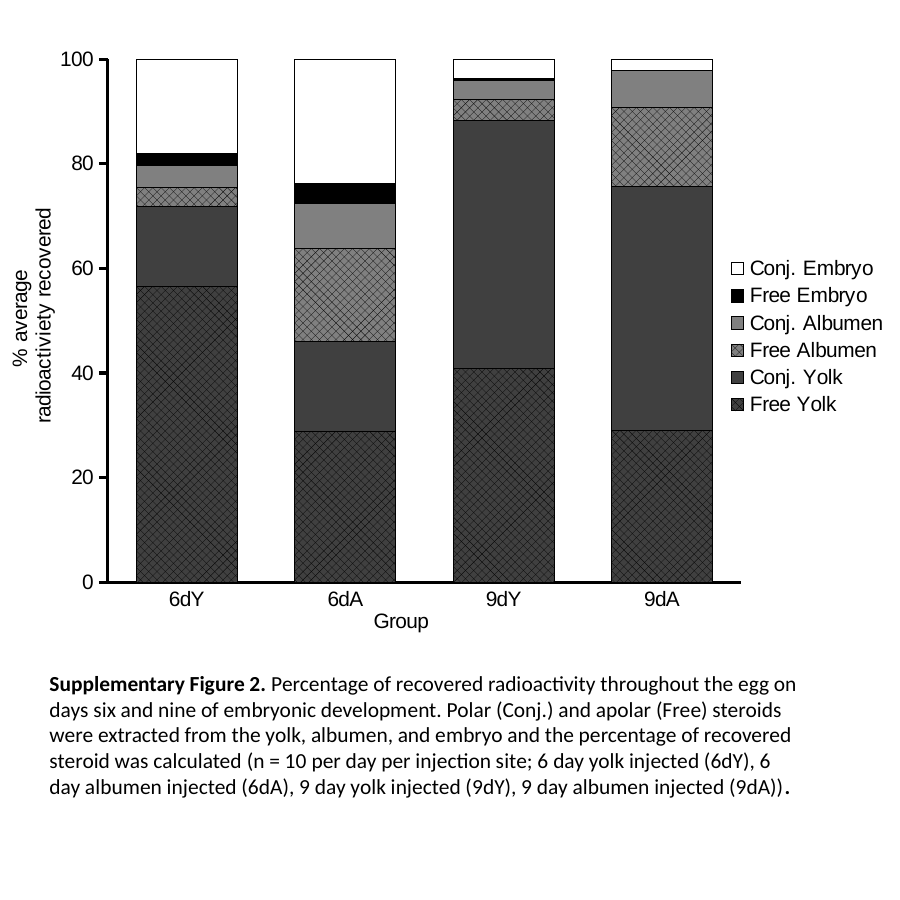
What kind of chart is shown on the slide? Stacked bar chart Is the Free Yolk value for 9dY greater or less than 20? greater What is the total height of the stacked bar for 6dY? 100 Which group has the highest Conj. Embryo value? 6dA Which group has the larger Free Albumen value, 9dA or 6dY? 9dA Which group has the larger Free Yolk value, 6dY or 6dA? 6dY What is the title of the x axis? Group How many series does the chart's legend list? 6 How many groups are shown on the x axis of the chart? 4 Is the Free Yolk value for 6dY greater or less than 40? greater Is the Free Yolk value for 6dA greater or less than 40? less Which group has the highest Free Yolk value? 6dY